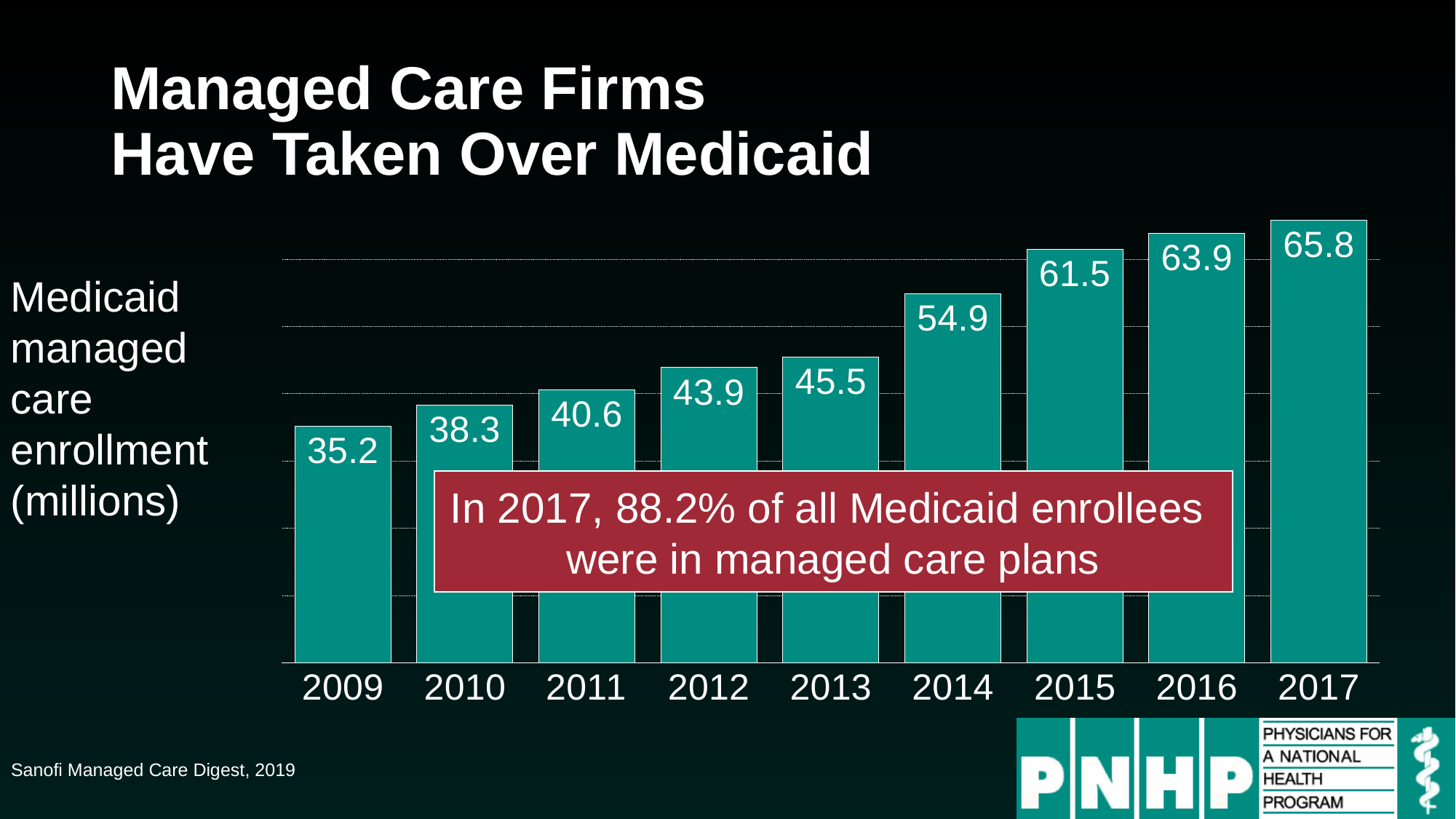
Which year had higher Medicaid managed care enrollment, 2012 or 2015? 2015 How many years are shown on the x axis of the chart? 9 Which year has the lowest Medicaid managed care enrollment? 2009 What is the difference in Medicaid managed care enrollment (millions) between 2017 and 2009? 30.6 What is the difference in Medicaid managed care enrollment (millions) between 2014 and 2013? 9.4 Which year has the highest Medicaid managed care enrollment? 2017 What kind of chart is shown on the slide? Bar chart What was Medicaid managed care enrollment (millions) in 2017? 65.8 Do the values rise or fall from 2009 to 2017? Rise According to the red box on the chart, what percentage of all Medicaid enrollees were in managed care plans in 2017? 88.2% What was Medicaid managed care enrollment (millions) in 2014? 54.9 What was Medicaid managed care enrollment (millions) in 2009? 35.2